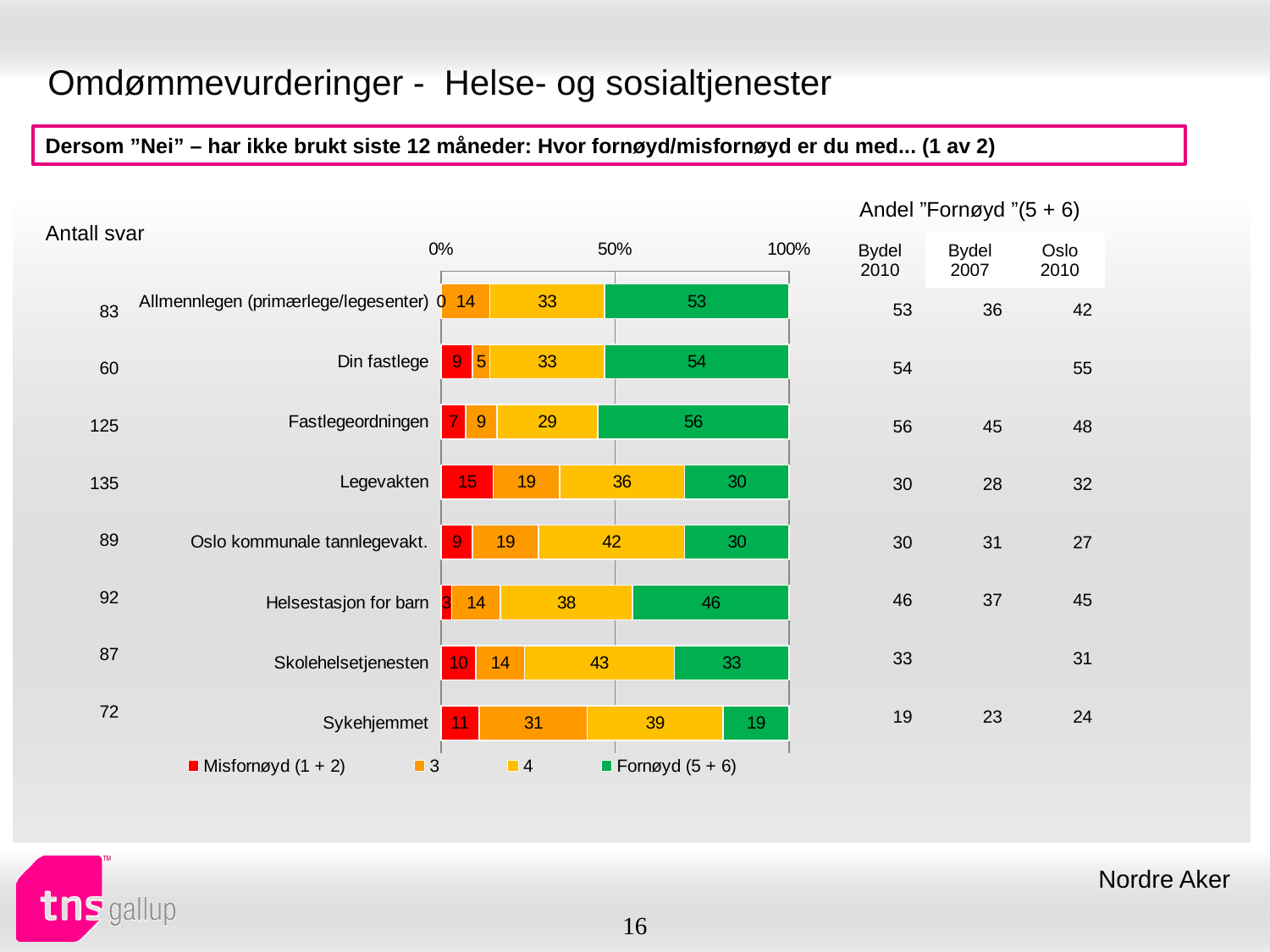
How many series does the legend list? 4 Which has the larger value for series "4": Skolehelsetjenesten or Helsestasjon for barn? Skolehelsetjenesten What is the total of the stacked bar for Sykehjemmet? 100 What is the difference between the "Fornøyd (5 + 6)" values for Legevakten and Sykehjemmet? 11 What is the value of series "3" for Sykehjemmet? 31 How many categories are shown in the chart? 8 Which category has the highest "Fornøyd (5 + 6)" value? Fastlegeordningen Which legend entry is shown in green? Fornøyd (5 + 6) What is the "Fornøyd (5 + 6)" value for Fastlegeordningen? 56 What is the "Misfornøyd (1 + 2)" value for Legevakten? 15 What kind of chart is shown on the slide? Stacked bar chart Which category has the lowest "Fornøyd (5 + 6)" value? Sykehjemmet